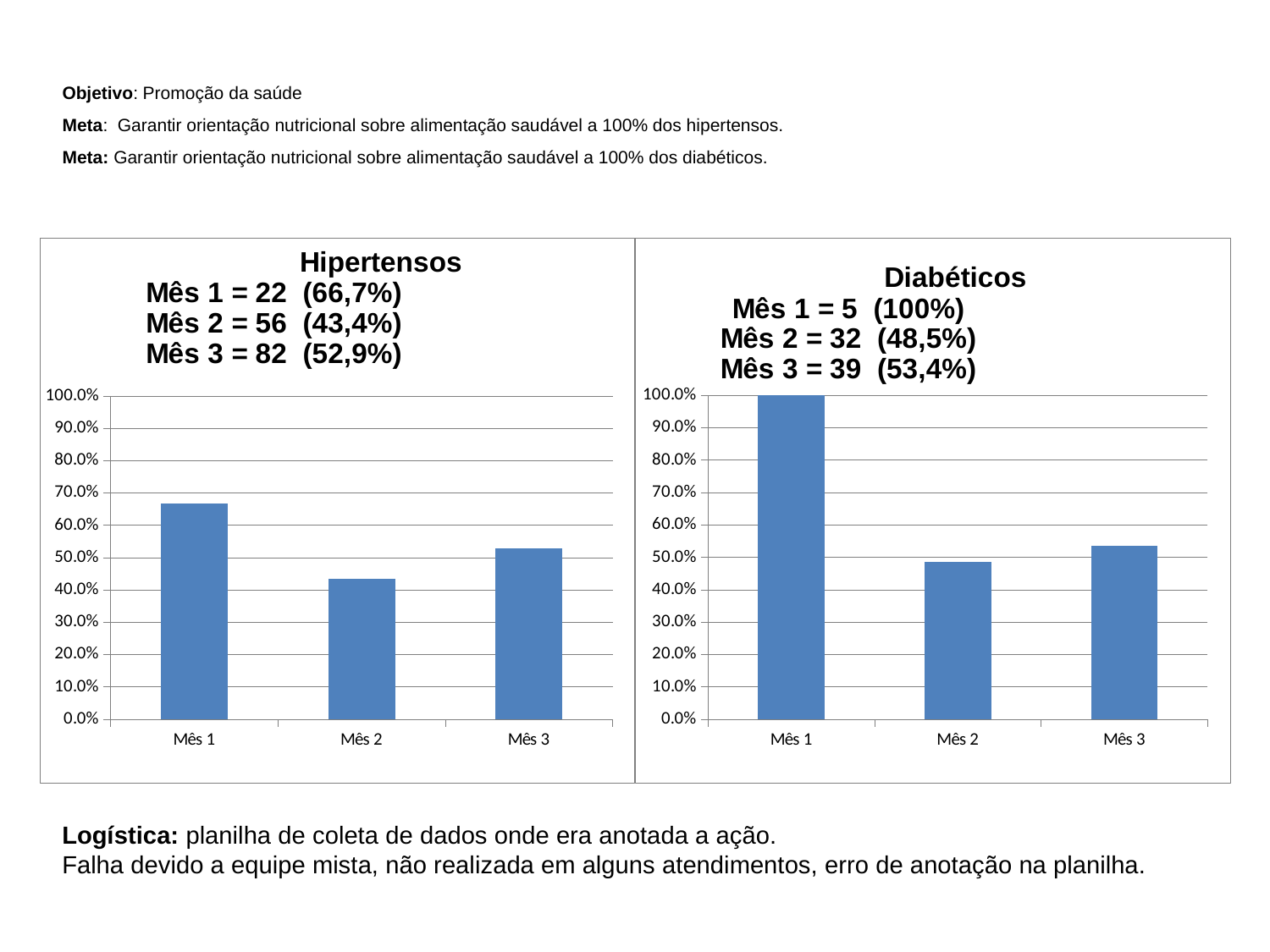
In the Diabéticos chart, which month has the highest bar? Mês 1 In the Diabéticos chart, is the bar for Mês 3 greater or less than 50.0%? greater What is the title of the chart on the right side of the slide? Diabéticos What type of chart is the Hipertensos chart? Bar chart In the Hipertensos chart, which is larger, the bar for Mês 1 or the bar for Mês 3? Mês 1 In the Hipertensos chart, which month has the lowest bar? Mês 2 In the Diabéticos chart, which month has the lowest bar? Mês 2 In the Hipertensos chart, what percentage is shown for Mês 1? 66,7% In the Hipertensos chart, which month has the highest bar? Mês 1 In the Hipertensos chart, is the bar for Mês 2 greater or less than 50.0%? less In the Diabéticos chart, what percentage is shown for Mês 2? 48,5% How many months (categories) are plotted in the Diabéticos chart? 3